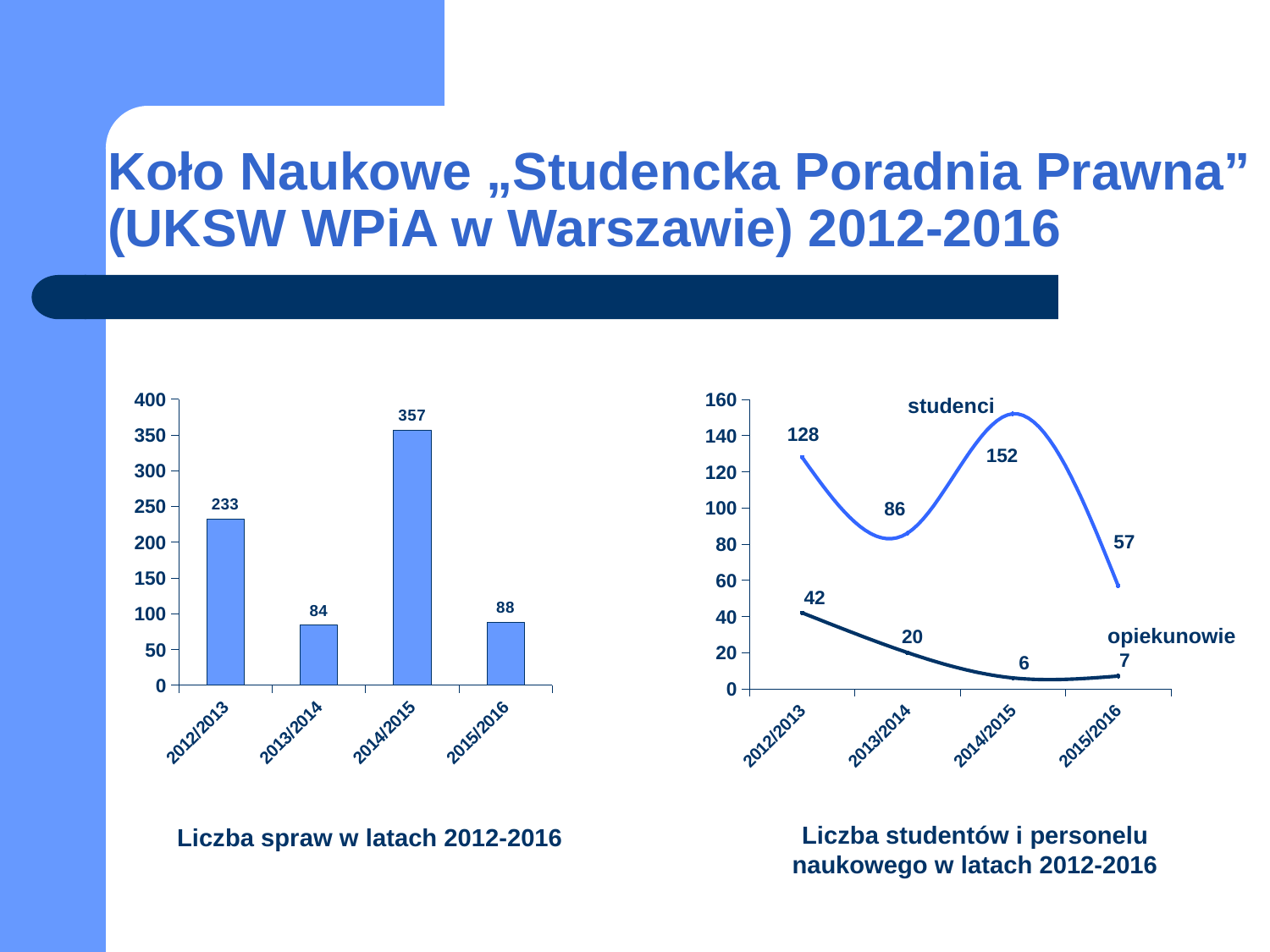
In the right chart (Liczba studentów i personelu naukowego), how many series are plotted? 2 In the right chart (Liczba studentów i personelu naukowego), what is the value for opiekunowie in 2015/2016? 7 In the left chart (Liczba spraw w latach 2012-2016), what is the difference between the values for 2014/2015 and 2012/2013? 124 In the left chart (Liczba spraw w latach 2012-2016), how many years are shown on the x axis? 4 What kind of chart is the left chart (Liczba spraw w latach 2012-2016)? bar chart In the right chart (Liczba studentów i personelu naukowego), what is the value for studenci in 2013/2014? 86 In the right chart (Liczba studentów i personelu naukowego), in which year is the studenci value highest? 2014/2015 In the left chart (Liczba spraw w latach 2012-2016), what is the value for 2014/2015? 357 What kind of chart is the right chart (Liczba studentów i personelu naukowego)? line chart In the right chart (Liczba studentów i personelu naukowego), does the opiekunowie series rise or fall from 2012/2013 to 2014/2015? fall In the left chart (Liczba spraw w latach 2012-2016), which year has the lowest value? 2013/2014 In the right chart (Liczba studentów i personelu naukowego), what is the difference between studenci and opiekunowie in 2012/2013? 86